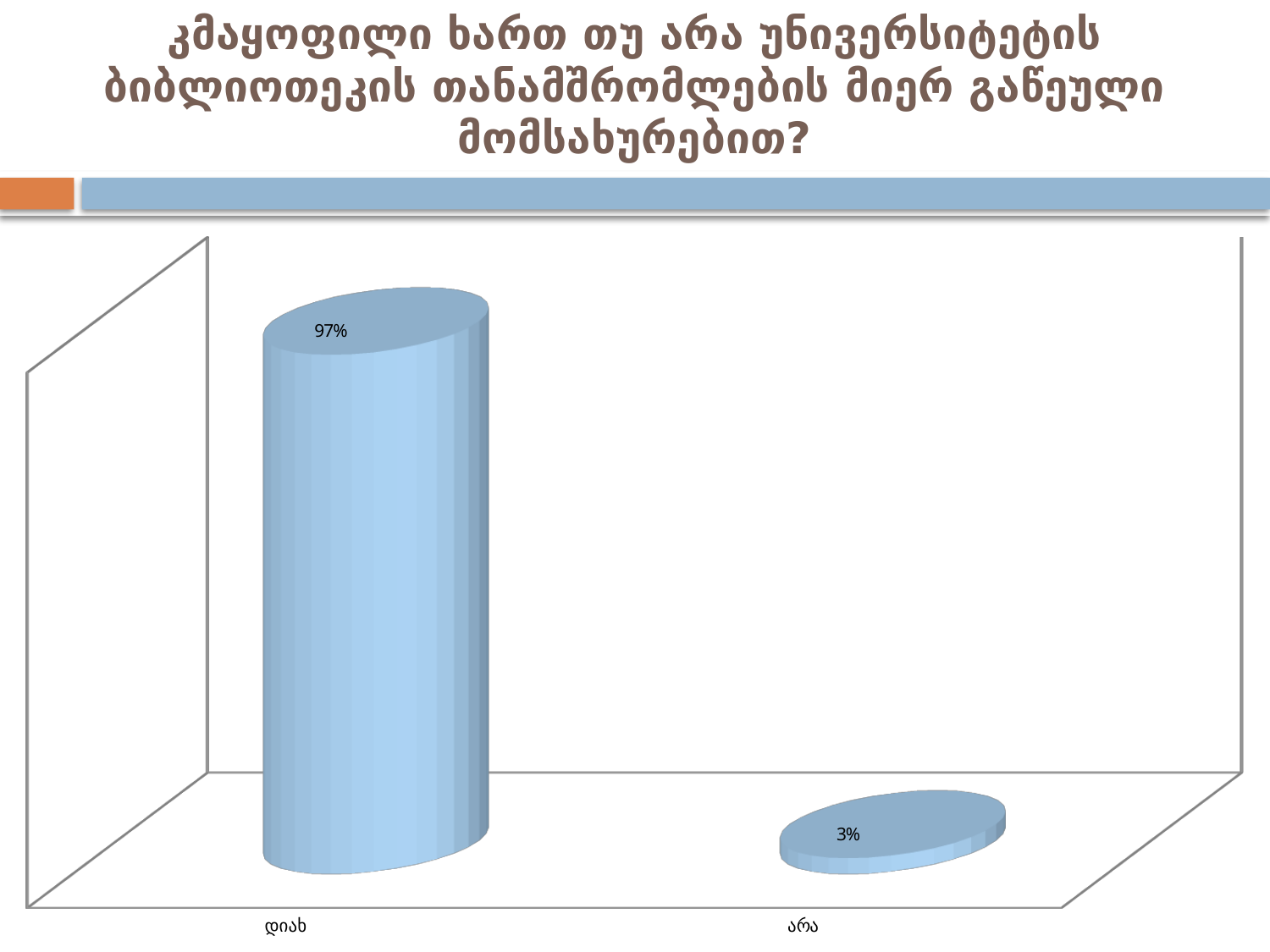
What is the difference between the values for დიახ and არა? 94% How many categories are shown on the chart? 2 What is the label of the category on the left of the chart? დიახ Which category has the lowest value? არა What is the value for არა? 3% Which category has the highest value? დიახ What kind of chart is shown on the slide? bar chart Which is larger, the value for დიახ or the value for არა? დიახ What is the title of the slide? კმაყოფილი ხართ თუ არა უნივერსიტეტის ბიბლიოთეკის თანამშრომლების მიერ გაწეული მომსახურებით? What is the total of the two values shown on the chart? 100% What is the value for დიახ? 97%